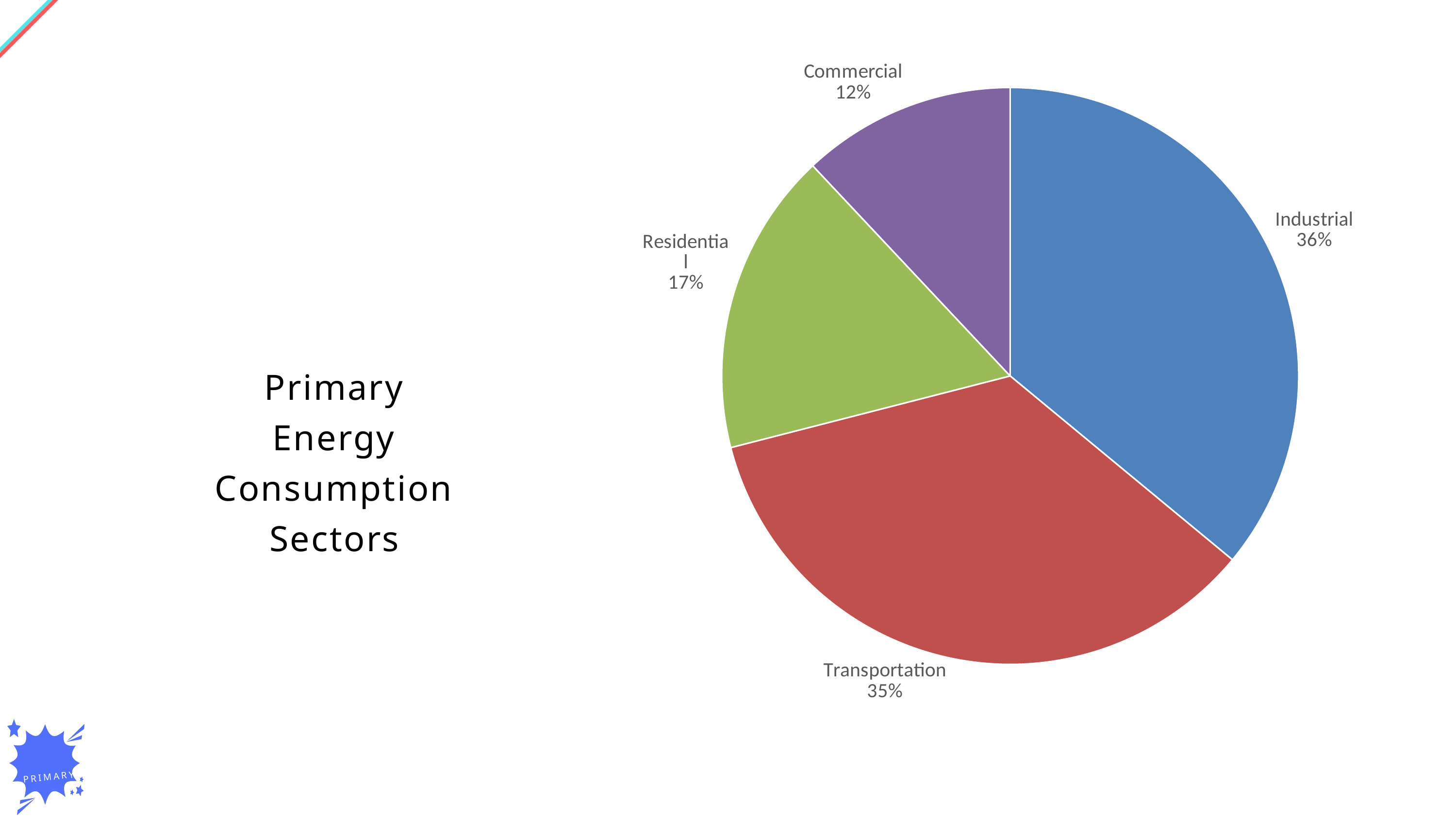
What colour is the Transportation slice? red How many slices does the pie chart have? 4 What is the difference in percentage points between the Residential and Commercial shares? 5 Which is larger, the Residential share or the Commercial share? Residential What share of the pie does the Transportation slice represent? 35% What share of the pie does the Commercial slice represent? 12% What share of the pie does the Residential slice represent? 17% Which sector has the smallest share of the pie? Commercial What is the difference in percentage points between the Industrial and Residential shares? 19 What is the title of the chart on the slide? Primary Energy Consumption Sectors What kind of chart is shown on the slide? pie chart